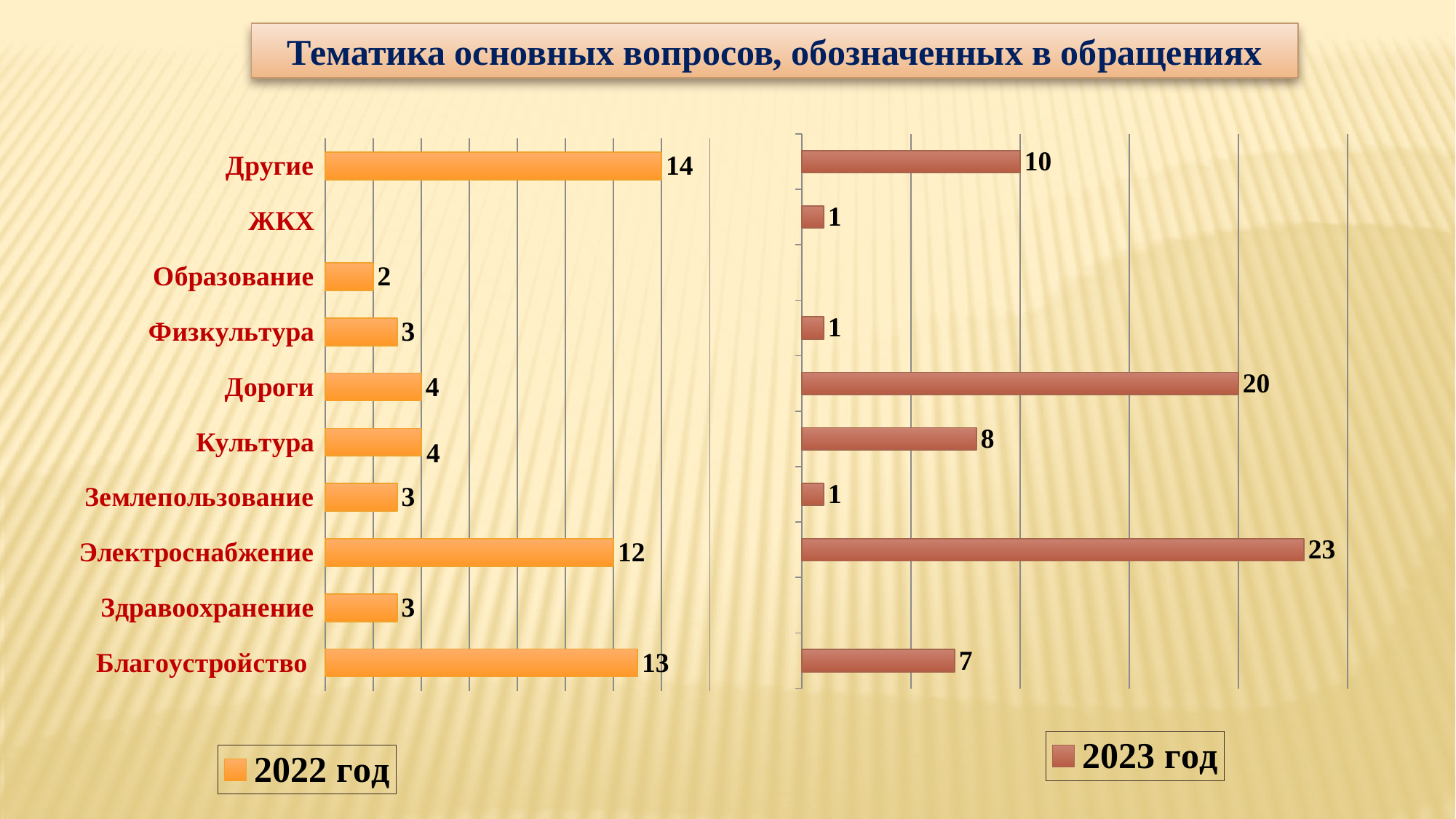
In the left chart (2022 год), what is the value for Электроснабжение? 12 What is the title of the slide? Тематика основных вопросов, обозначенных в обращениях In the left chart (2022 год), which category has the lowest value among those with a bar? Образование In the right chart (2023 год), what is the difference between Электроснабжение and Дороги? 3 In the left chart (2022 год), which category has the highest value? Другие In the right chart (2023 год), which category has the highest value? Электроснабжение In the right chart (2023 год), what is the value for Дороги? 20 How many category labels are listed on the left chart's axis? 10 In the left chart (2022 год), what is the difference between Другие and Благоустройство? 1 What type of chart is used on this slide? Bar chart Which is larger: Благоустройство in the 2022 год chart or Благоустройство in the 2023 год chart? 2022 год In the right chart (2023 год), which is larger: Культура or Другие? Другие